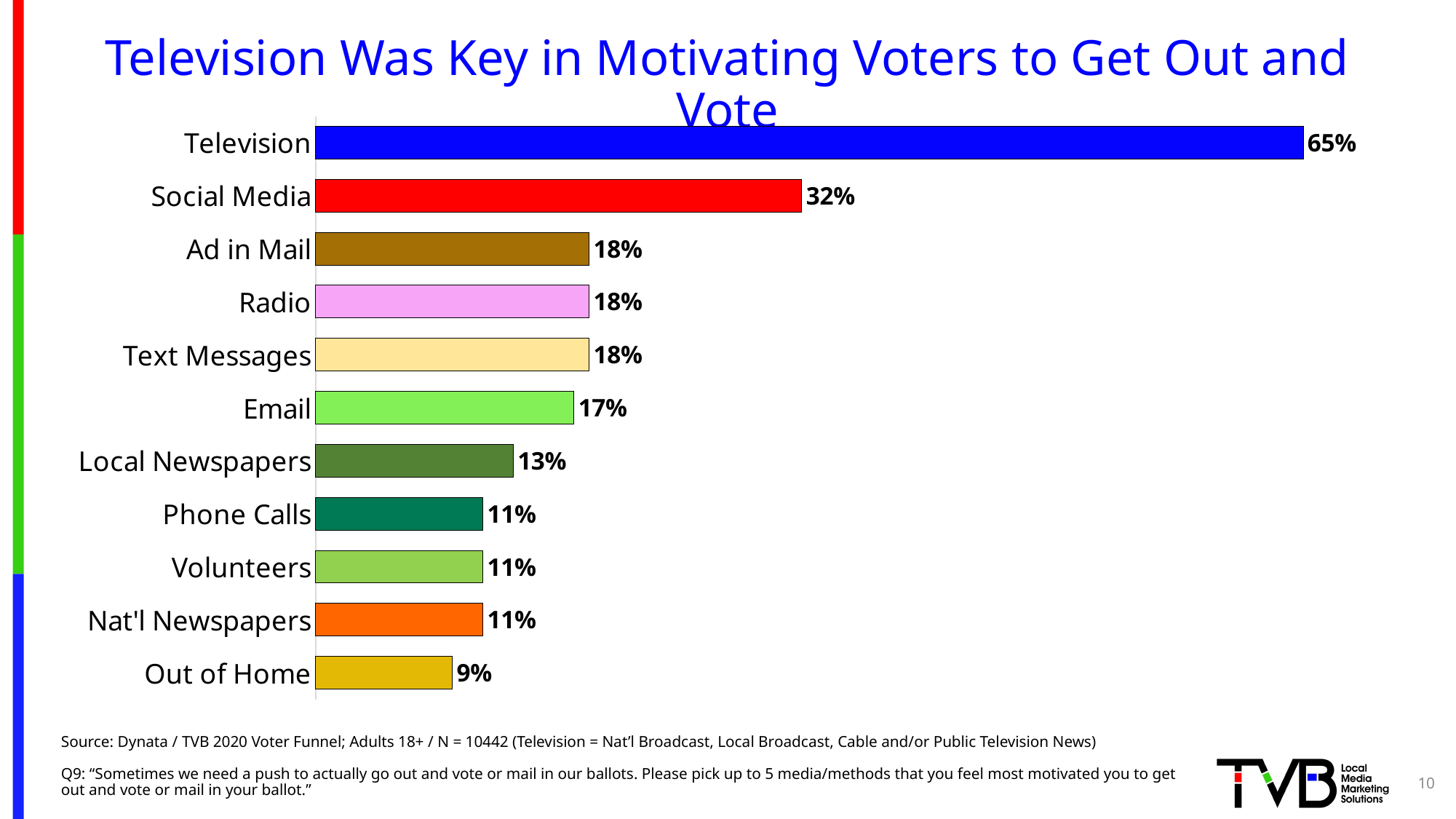
What kind of chart is shown on the slide? Bar chart What is the value shown for Local Newspapers? 13% What colour is the bar for Television? Blue What is the difference between the values for Email and Out of Home? 8 percentage points Which is larger, the value for Social Media or the value for Ad in Mail? Social Media How many categories are shown in the chart? 11 Which category has the lowest value in the chart? Out of Home What percentage of respondents said Television motivated them to get out and vote? 65% What is the value shown for Phone Calls? 11% What is the value shown for Social Media? 32% Which category has the highest value in the chart? Television What is the difference between the values for Television and Social Media? 33 percentage points